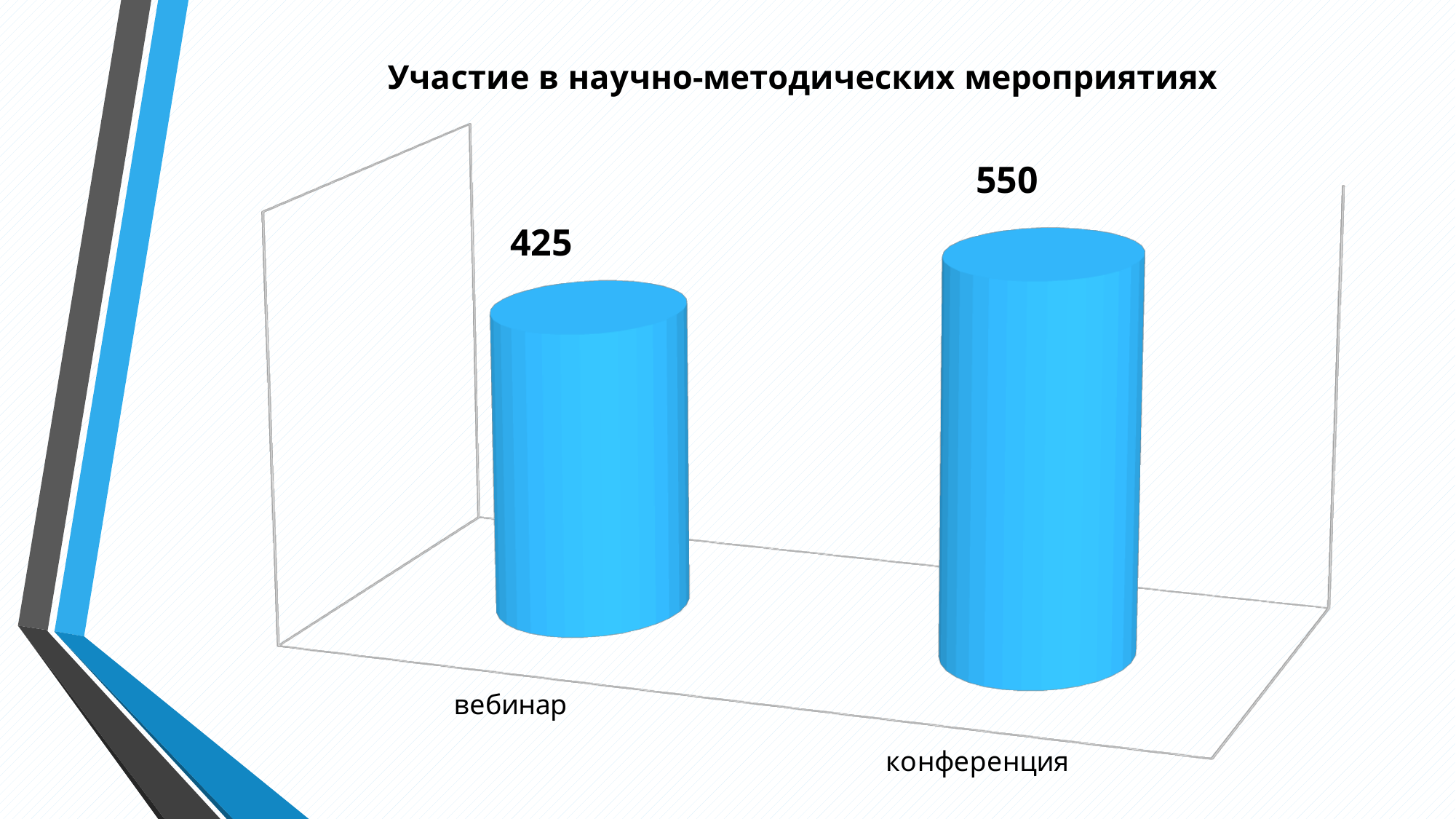
What is the title of the chart? Участие в научно-методических мероприятиях What kind of chart is shown on the slide? bar chart Which category has the highest value? конференция What colour are the bars in the chart? blue Do the values rise or fall from вебинар to конференция? rise What is the difference between the values for конференция and вебинар? 125 What is the value for конференция? 550 What is the value for вебинар? 425 Which is larger, the value for вебинар or the value for конференция? конференция Which category has the lowest value? вебинар How many categories are shown in the chart? 2